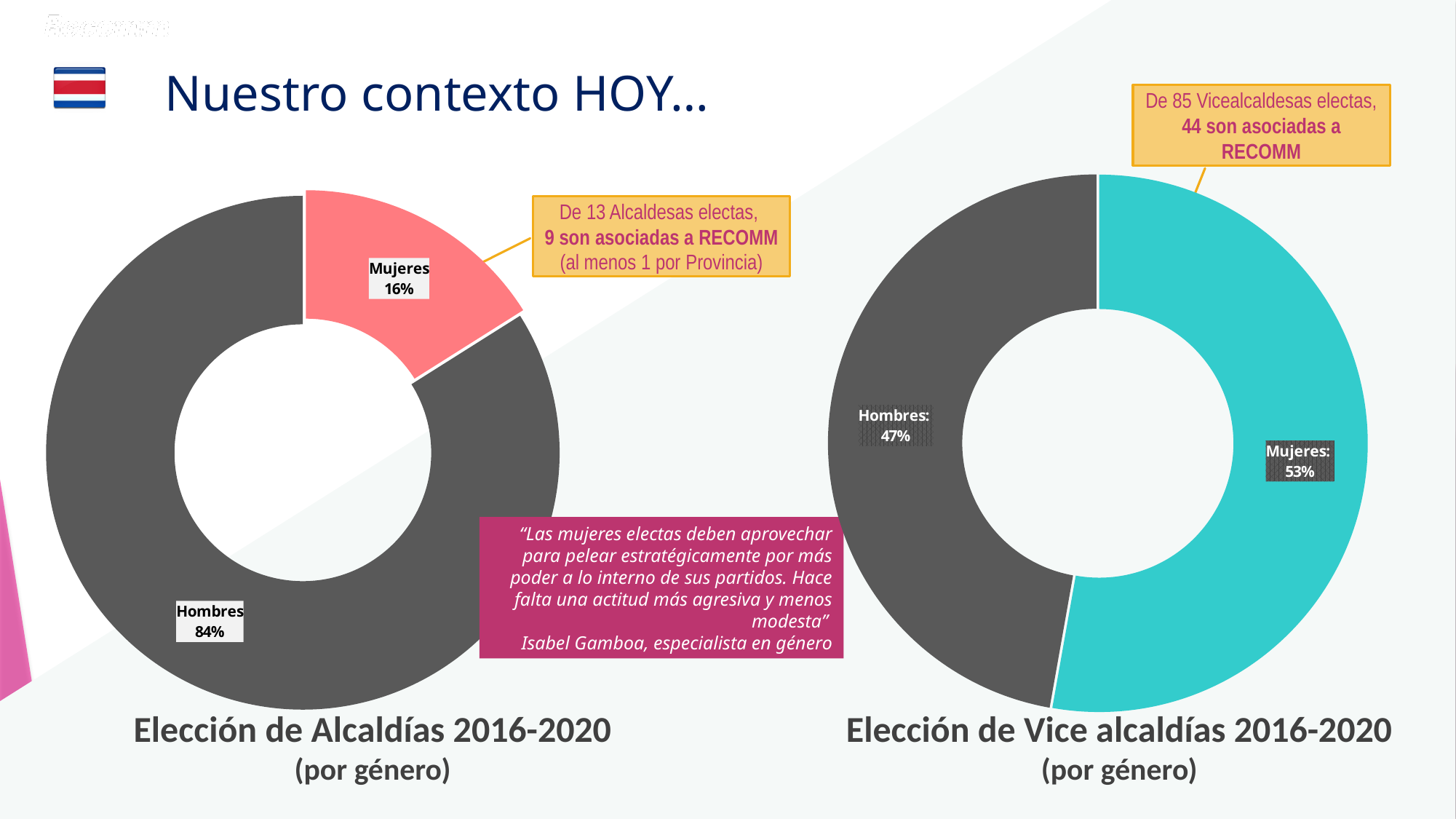
In the 'Elección de Vice alcaldías 2016-2020' chart, what is the difference in percentage points between Mujeres and Hombres? 6 In the 'Elección de Vice alcaldías 2016-2020' chart, which is larger, Mujeres or Hombres? Mujeres In the 'Elección de Vice alcaldías 2016-2020' chart, what colour is the Mujeres slice? Teal (turquoise) In the 'Elección de Alcaldías 2016-2020' chart, which category has the largest share? Hombres In the 'Elección de Alcaldías 2016-2020' chart, what percentage is shown for Mujeres? 16% In the 'Elección de Vice alcaldías 2016-2020' chart, what percentage is shown for Hombres? 47% In the 'Elección de Vice alcaldías 2016-2020' chart, which category has the smallest share? Hombres In the 'Elección de Alcaldías 2016-2020' chart, what percentage is shown for Hombres? 84% What kind of chart is the 'Elección de Alcaldías 2016-2020' chart? Doughnut (pie) chart In the 'Elección de Vice alcaldías 2016-2020' chart, what percentage is shown for Mujeres? 53% In the 'Elección de Alcaldías 2016-2020' chart, what is the difference in percentage points between Hombres and Mujeres? 68 How many categories does the 'Elección de Vice alcaldías 2016-2020' chart show? 2